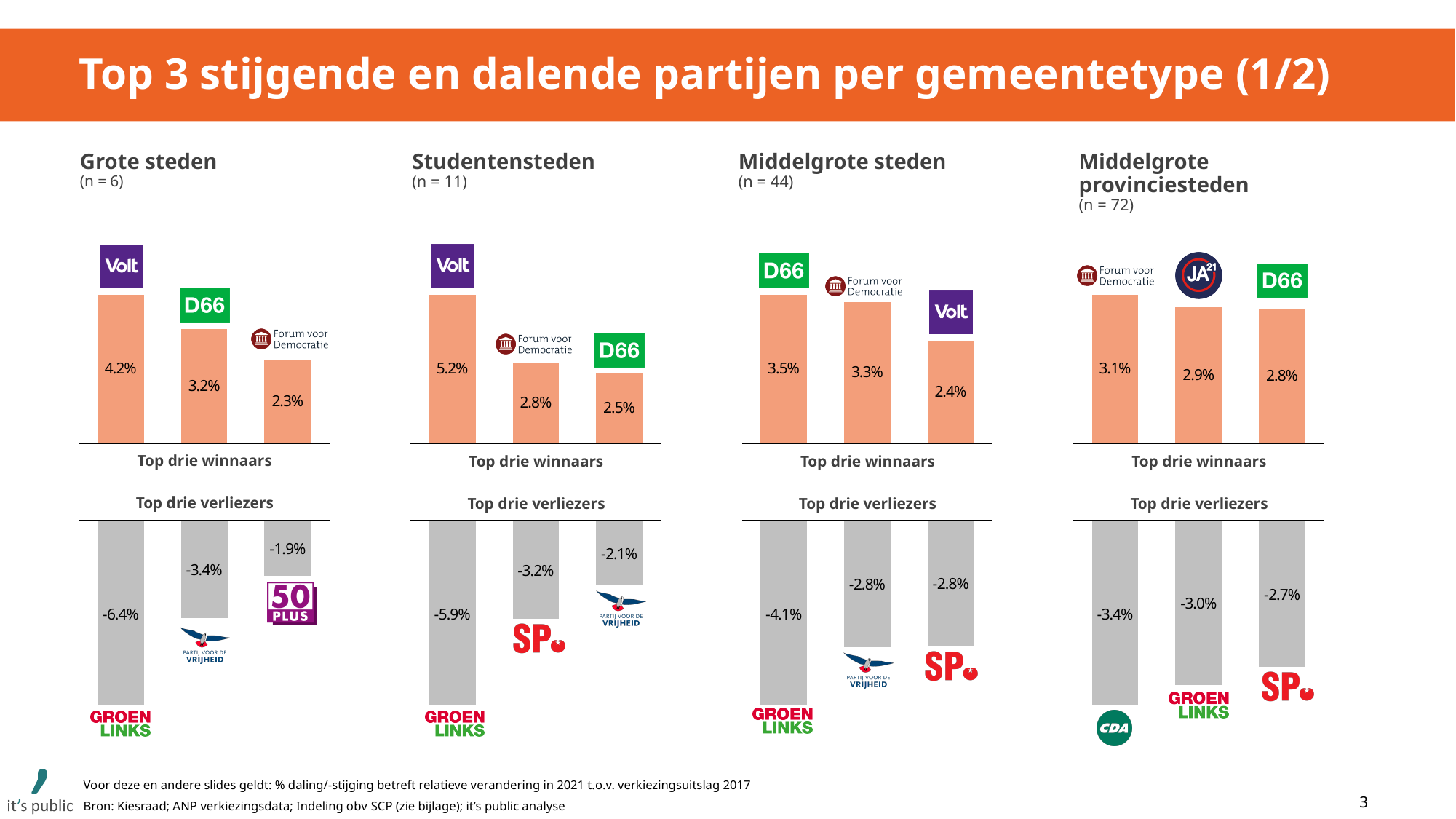
In the Studentensteden chart, what is the value shown for GroenLinks among the top three losers? -5.9% In the Middelgrote steden chart, what is the value shown for Volt among the winners? 2.4% What is the number of municipalities (n) given for Middelgrote provinciesteden? 72 In the Studentensteden chart, which is larger: the value for Forum voor Democratie or the value for D66? Forum voor Democratie How many parties are shown in the Grote steden top three losers chart? 3 In the Grote steden chart, what is the value shown for Volt among the top three winners? 4.2% In the Middelgrote provinciesteden chart, what is the value shown for JA21? 2.9% What kind of chart is used to show the top three winners for Studentensteden? bar chart In the Middelgrote provinciesteden chart, which party has the largest decline among the top three losers? CDA In the Grote steden chart, what is the difference between the values for Volt and D66 among the winners? 1.0% In the Middelgrote steden chart, which party has the highest value among the top three winners? D66 In the Grote steden chart, what is the value shown for 50PLUS among the losers? -1.9%